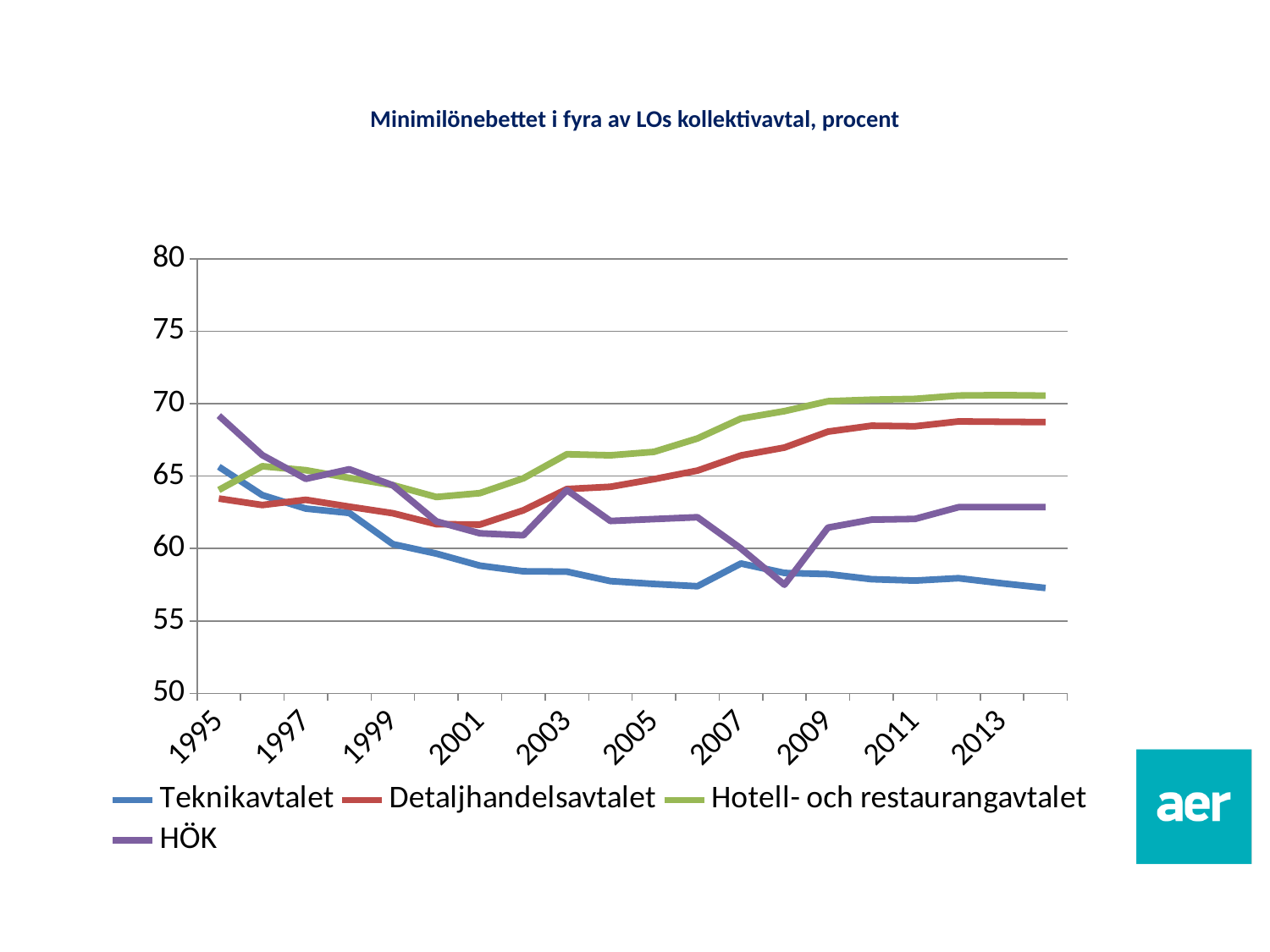
Which series has the highest value in 2013? Hotell- och restaurangavtalet In 2009, which is larger: Detaljhandelsavtalet or HÖK? Detaljhandelsavtalet Does the Teknikavtalet line rise or fall from 1995 to 2013? fall What kind of chart is shown on the slide? line chart Which series is drawn in green? Hotell- och restaurangavtalet What is the title of the chart? Minimilönebettet i fyra av LOs kollektivavtal, procent Is the value for HÖK in 1995 greater or less than 65? greater Is the value for Detaljhandelsavtalet in 2001 greater or less than 65? less Is the value for Teknikavtalet in 2013 greater or less than 60? less Which series has the lowest value in 2013? Teknikavtalet How many series does the legend list? 4